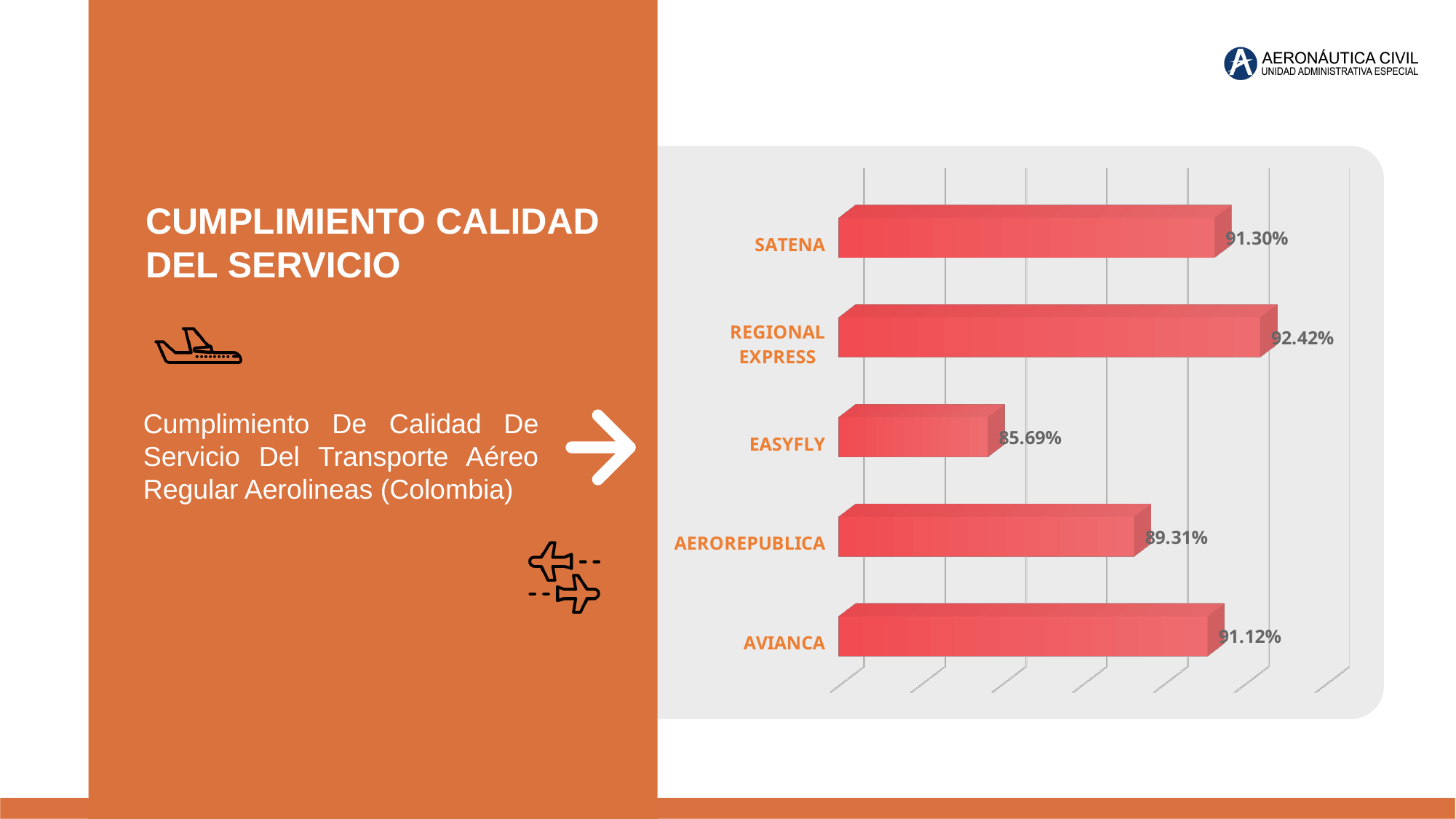
Which airline has the highest value in the chart? REGIONAL EXPRESS What is the value shown for SATENA? 91.30% What is the value shown for AEROREPUBLICA? 89.31% What is the difference between the values for SATENA and AEROREPUBLICA? 1.99% What is the difference between the values for REGIONAL EXPRESS and EASYFLY? 6.73% How many airlines are shown in the chart? 5 What kind of chart is shown on the slide? Bar chart Which has a larger value, AVIANCA or AEROREPUBLICA? AVIANCA What is the value shown for AVIANCA? 91.12% What is the value shown for EASYFLY? 85.69% What is the value shown for REGIONAL EXPRESS? 92.42% Which airline has the lowest value in the chart? EASYFLY